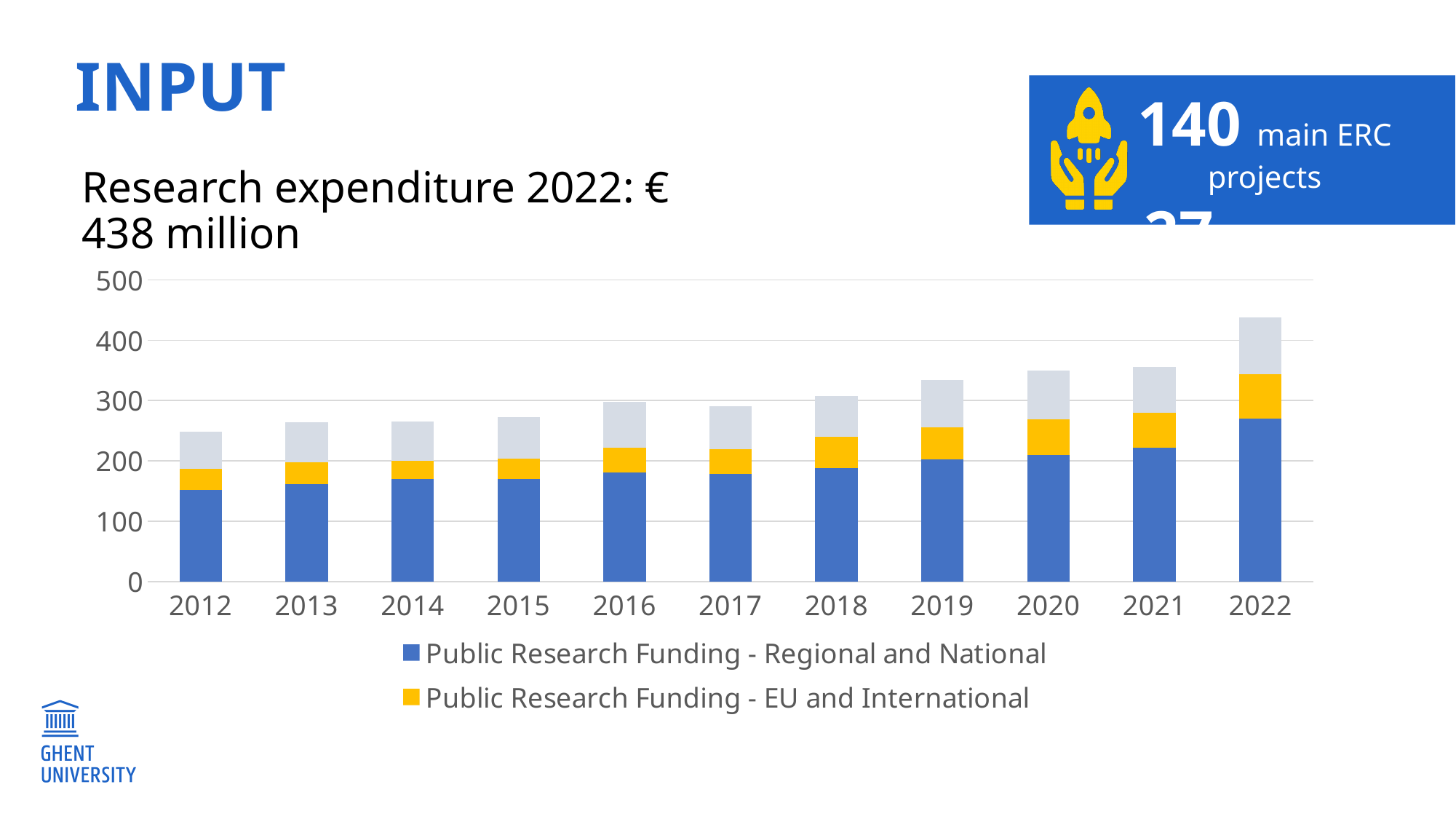
Which year has the tallest bar in the chart? 2022 Is the Public Research Funding - Regional and National value for 2012 greater or less than 200? less Which year has the larger total bar, 2021 or 2022? 2022 What colour represents Public Research Funding - EU and International in the legend? Yellow What kind of chart is shown on the slide? Stacked bar chart Is the Public Research Funding - Regional and National value for 2022 greater or less than 200? greater Do the total bar heights generally rise or fall from 2012 to 2022? Rise Is the total bar height for 2022 greater or less than 400? greater How many series does the chart's legend list? 2 Which year has the shortest bar in the chart? 2012 How many years are shown on the x axis of the chart? 11